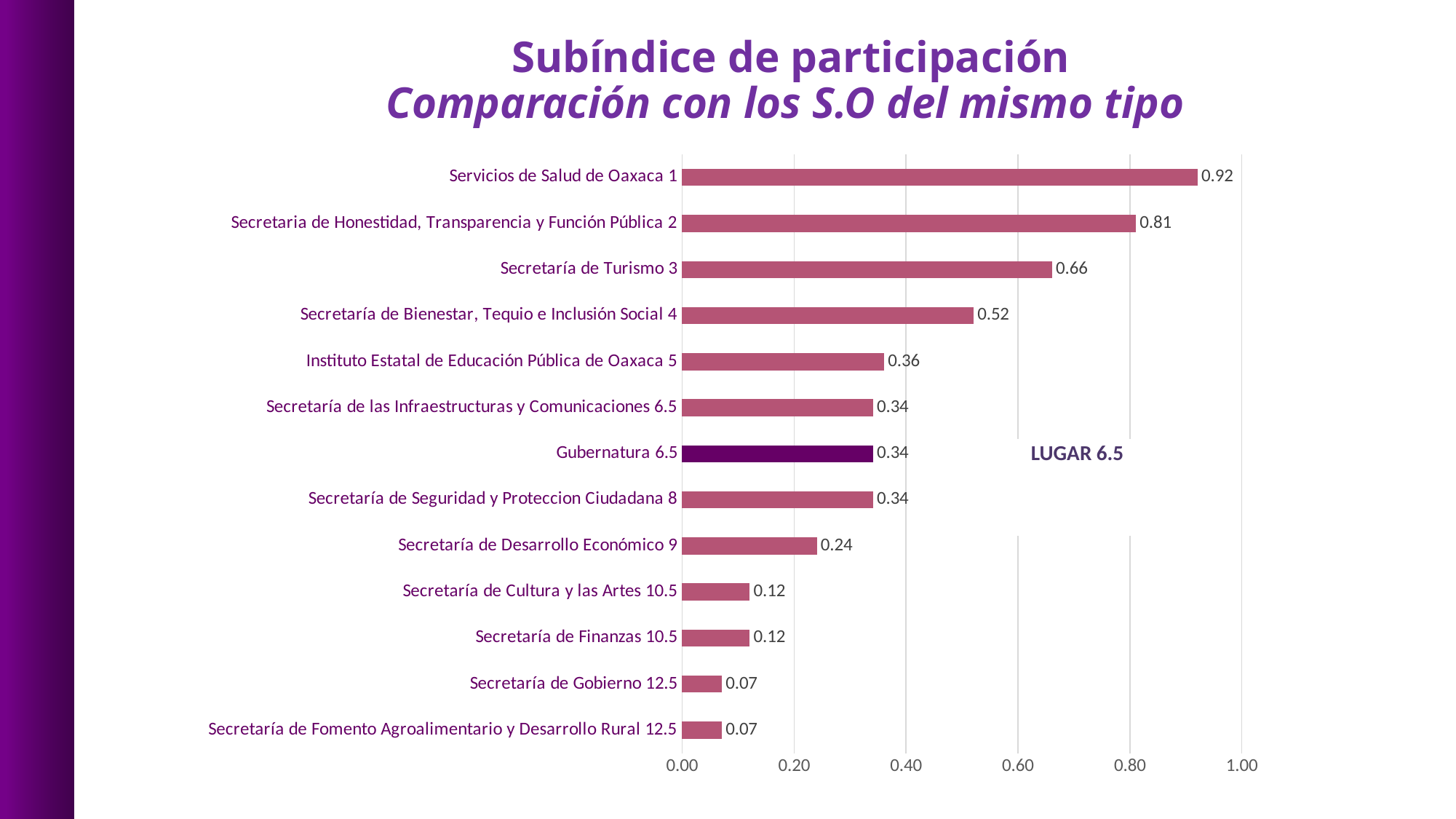
What is the value for Servicios de Salud de Oaxaca 1? 0.92 Which is larger, the value for Secretaría de Turismo 3 or the value for Instituto Estatal de Educación Pública de Oaxaca 5? Secretaría de Turismo 3 Is the value for Secretaria de Honestidad, Transparencia y Función Pública 2 greater or less than 0.60? greater What is the value for Gubernatura 6.5? 0.34 What is the value for Secretaría de Turismo 3? 0.66 Which category has the highest value? Servicios de Salud de Oaxaca 1 What is the difference between the values for Servicios de Salud de Oaxaca 1 and Secretaria de Honestidad, Transparencia y Función Pública 2? 0.11 Which bar is highlighted in a darker colour than the others? Gubernatura 6.5 How many categories are shown in the chart? 13 What is the difference between the values for Secretaría de Bienestar, Tequio e Inclusión Social 4 and Gubernatura 6.5? 0.18 What kind of chart is shown on the slide? Bar chart What is the value for Secretaría de Desarrollo Económico 9? 0.24